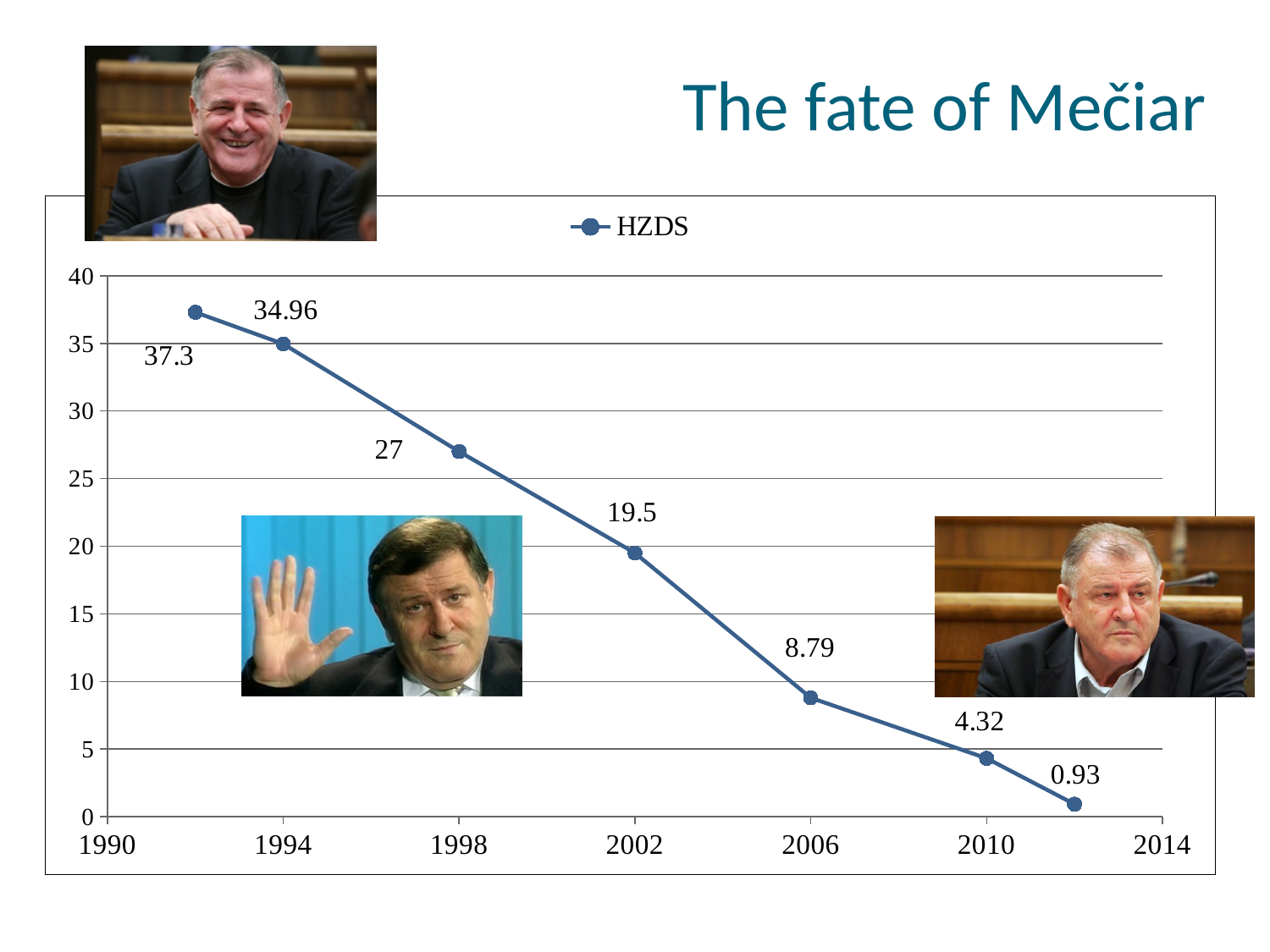
What is the difference between the HZDS values for 1994 and 1998? 7.96 What is the HZDS value for 2002? 19.5 What is the HZDS value for 2010? 4.32 What is the HZDS value for 1994? 34.96 What is the highest HZDS value plotted on the chart? 37.3 Do the HZDS values rise or fall over time along the x axis? fall What type of chart is shown on the slide? line chart What is the lowest HZDS value plotted on the chart? 0.93 What is the HZDS value for 2006? 8.79 How many data points are plotted on the chart? 7 Which year has the larger HZDS value, 2002 or 2006? 2002 What is the HZDS value for 1998? 27